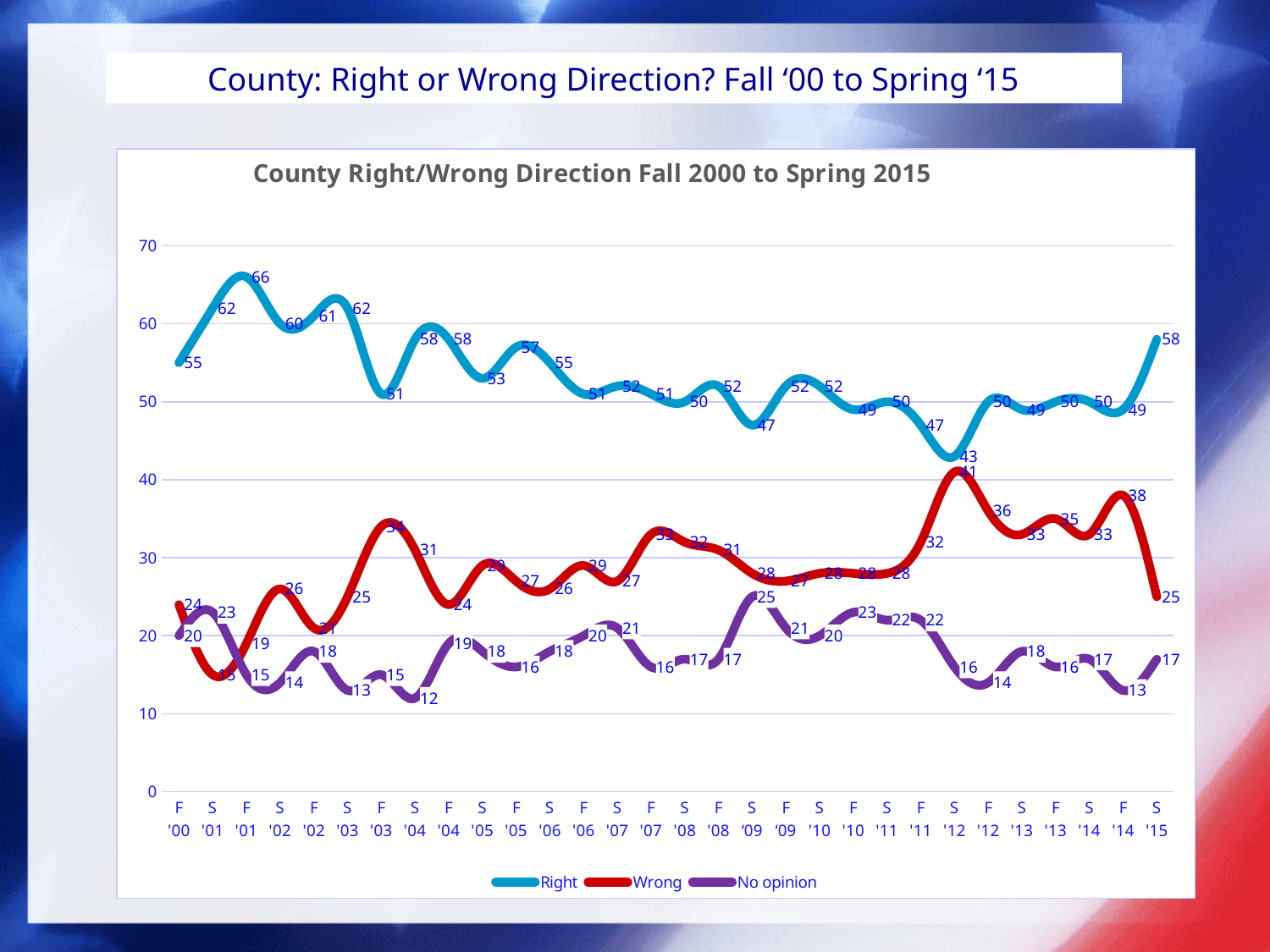
What is the value of the Wrong series at S '12? 41 Which is larger: the Wrong value at F '14 or the Wrong value at S '15? F '14 What is the value of the Right series at F '00? 55 At which point does the Right series reach its lowest value? S '12 What are the three series named in the legend? Right, Wrong, No opinion What is the value of the Wrong series at F '03? 34 What is the difference between the Right and Wrong values at S '15? 33 At which point does the Right series reach its highest value? F '01 How many data points are plotted along the x axis for each series? 30 What kind of chart is shown on the slide? line chart How many series does the legend list? 3 What is the value of the No opinion series at S '04? 12